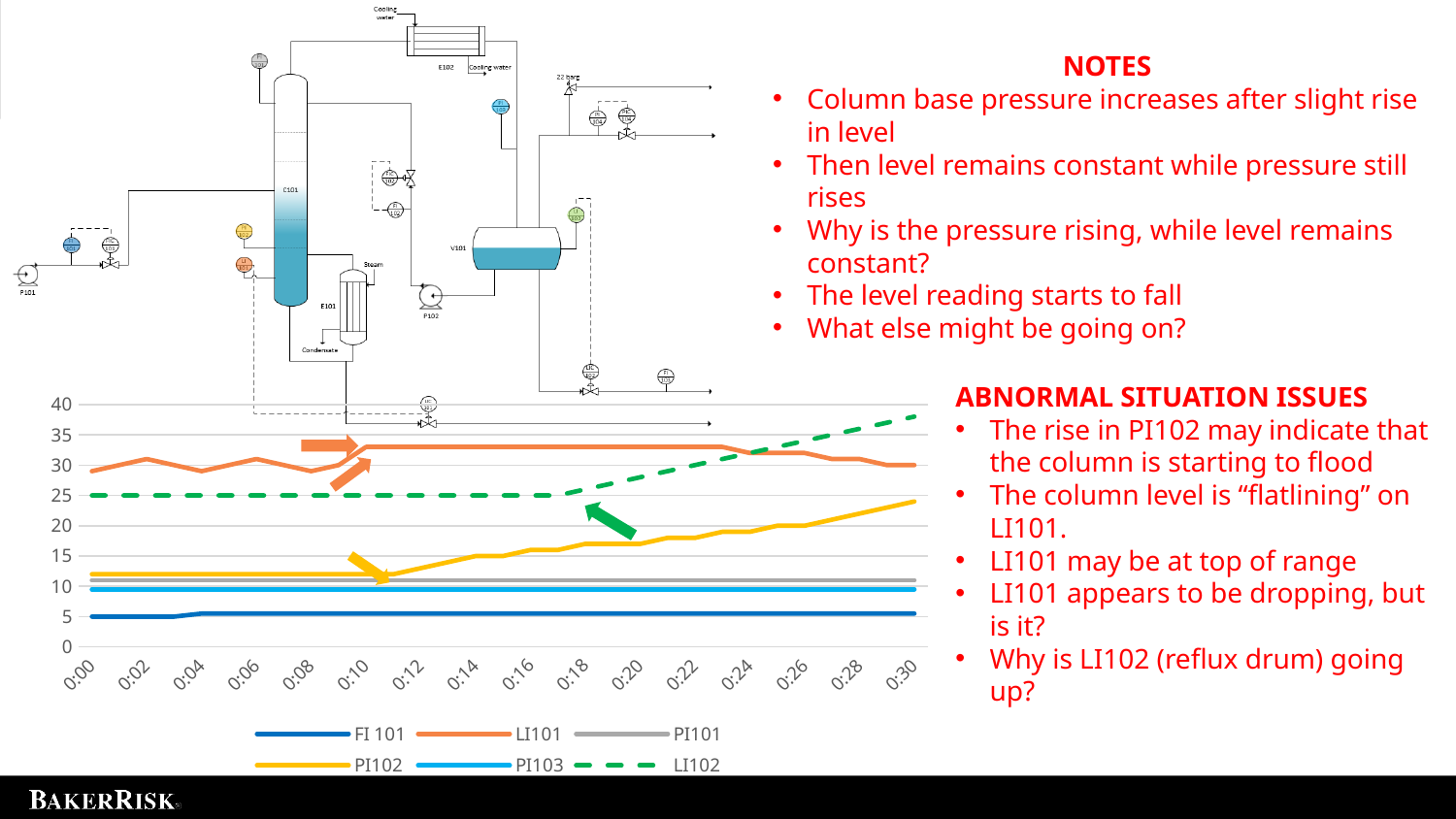
Is the value of FI 101 at 0:30 greater or less than 10? less Which series has the highest value at 0:30? LI102 What kind of chart is shown on the slide? line chart At 0:00, which is larger, LI101 or LI102? LI101 Which series has the lowest value at 0:30? FI 101 How many time labels are shown along the x axis of the chart? 16 Is the value of PI102 at 0:30 greater or less than 20? greater Does the LI102 series rise or fall along the x axis from 0:18 to 0:30? rises Is the value of LI101 at 0:30 greater or less than 25? greater Does the PI102 series rise or fall along the x axis from 0:10 to 0:30? rises How many series does the chart legend list? 6